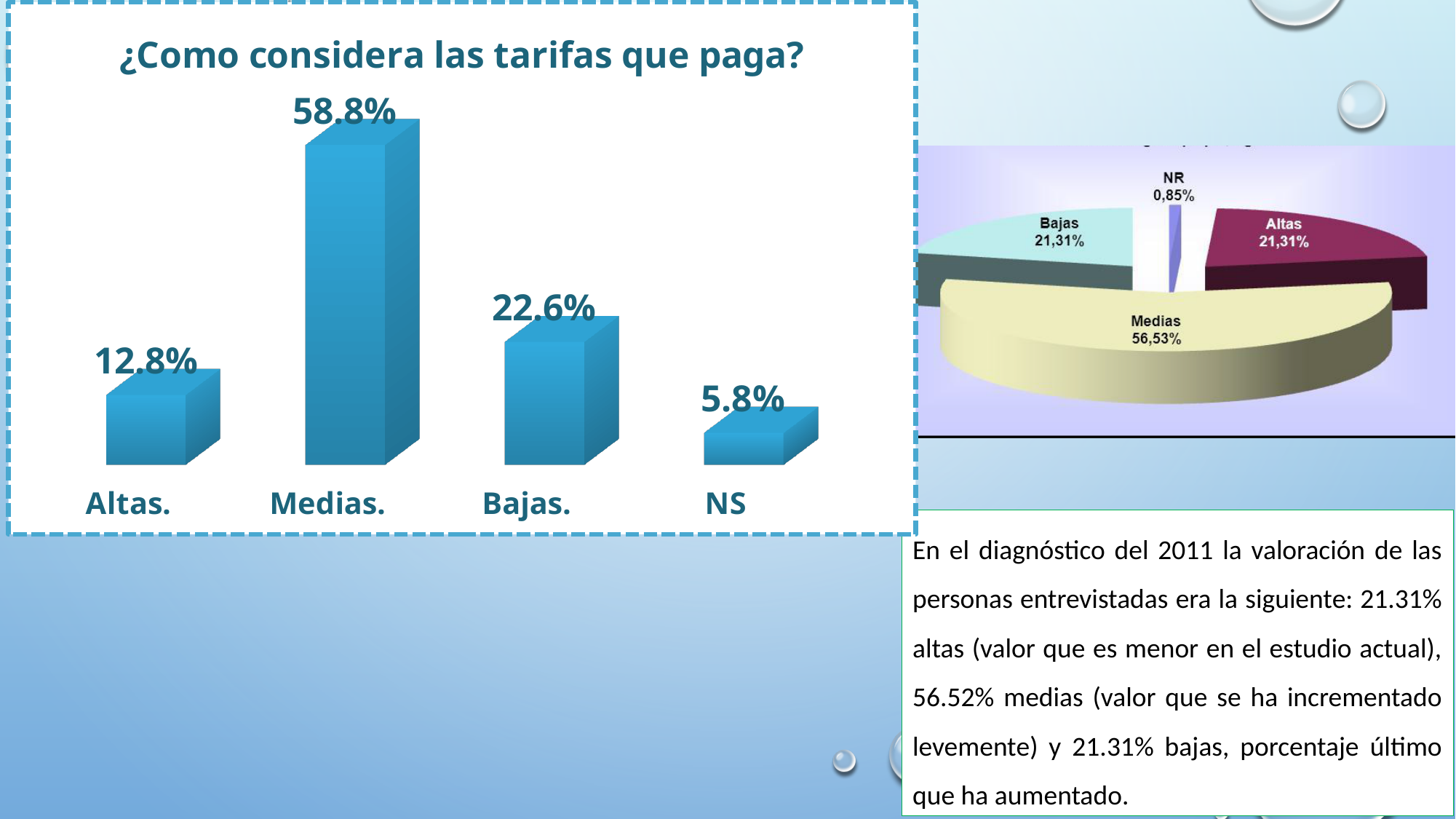
In the bar chart '¿Como considera las tarifas que paga?', what is the value for Medias? 58.8% What kind of chart is the one on the right of the slide? Pie chart How many categories are shown in the bar chart '¿Como considera las tarifas que paga?'? 4 In the pie chart on the right of the slide, what is the share for NR? 0,85% What kind of chart is the one on the left of the slide, titled '¿Como considera las tarifas que paga?'? Bar chart In the bar chart '¿Como considera las tarifas que paga?', what is the value for NS? 5.8% In the bar chart '¿Como considera las tarifas que paga?', which category has the highest value? Medias In the bar chart '¿Como considera las tarifas que paga?', which is larger, the value for Bajas or the value for Altas? Bajas In the bar chart '¿Como considera las tarifas que paga?', which category has the lowest value? NS In the pie chart on the right of the slide, what is the share for Medias? 56,53% In the bar chart '¿Como considera las tarifas que paga?', what is the value for Altas? 12.8% In the bar chart '¿Como considera las tarifas que paga?', what is the difference between the values for Bajas and Altas? 9.8%